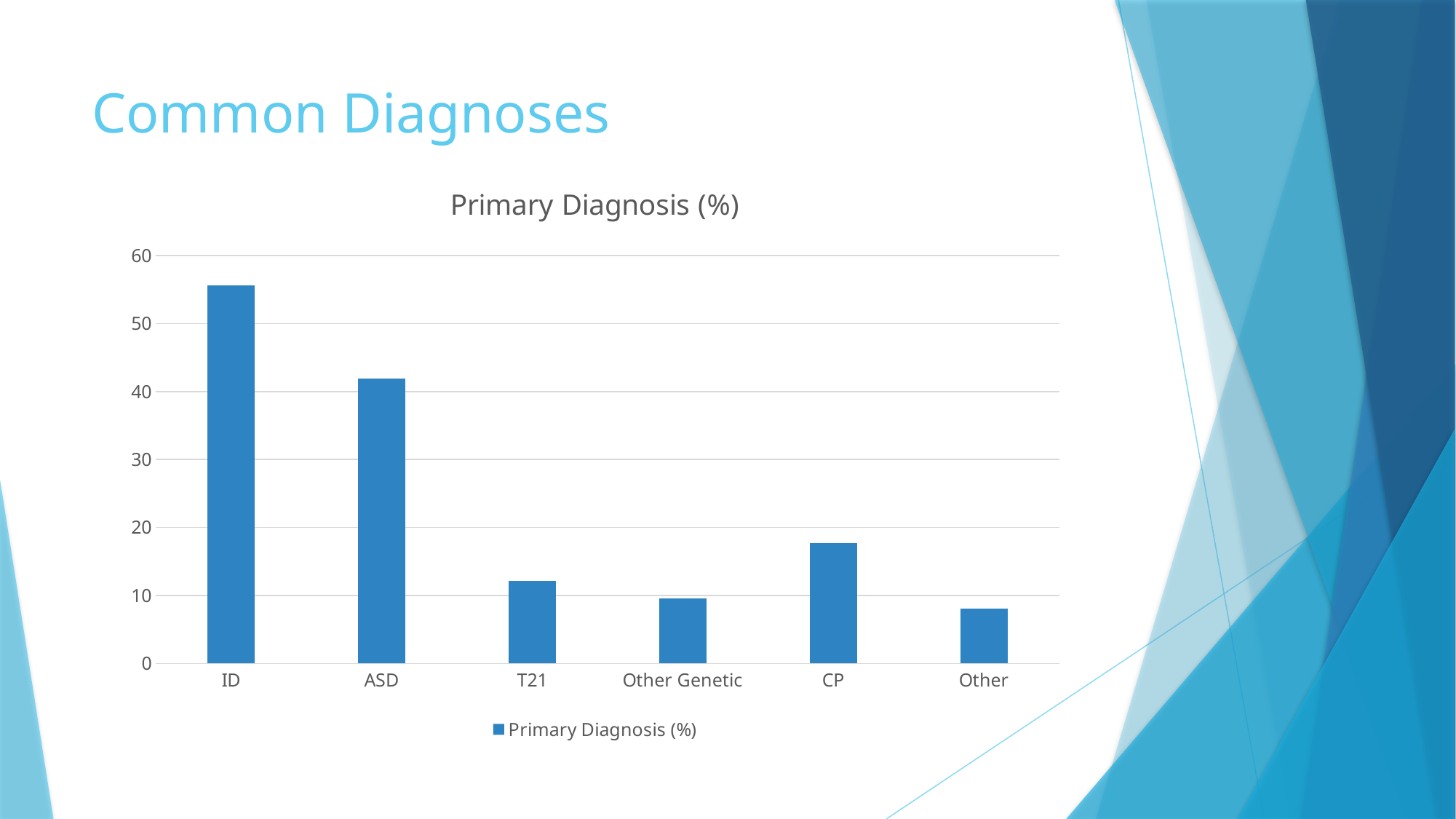
Which has a larger value, CP or T21? CP Which category has the highest value in the chart? ID What type of chart is shown on the slide? bar chart Which has a larger value, ASD or CP? ASD Is the value for CP greater or less than 20? less How many series does the legend list? 1 Is the value for T21 greater or less than 20? less Is the value for ASD greater or less than 40? greater How many categories are shown on the x axis of the chart? 6 What is the title of the chart? Primary Diagnosis (%)